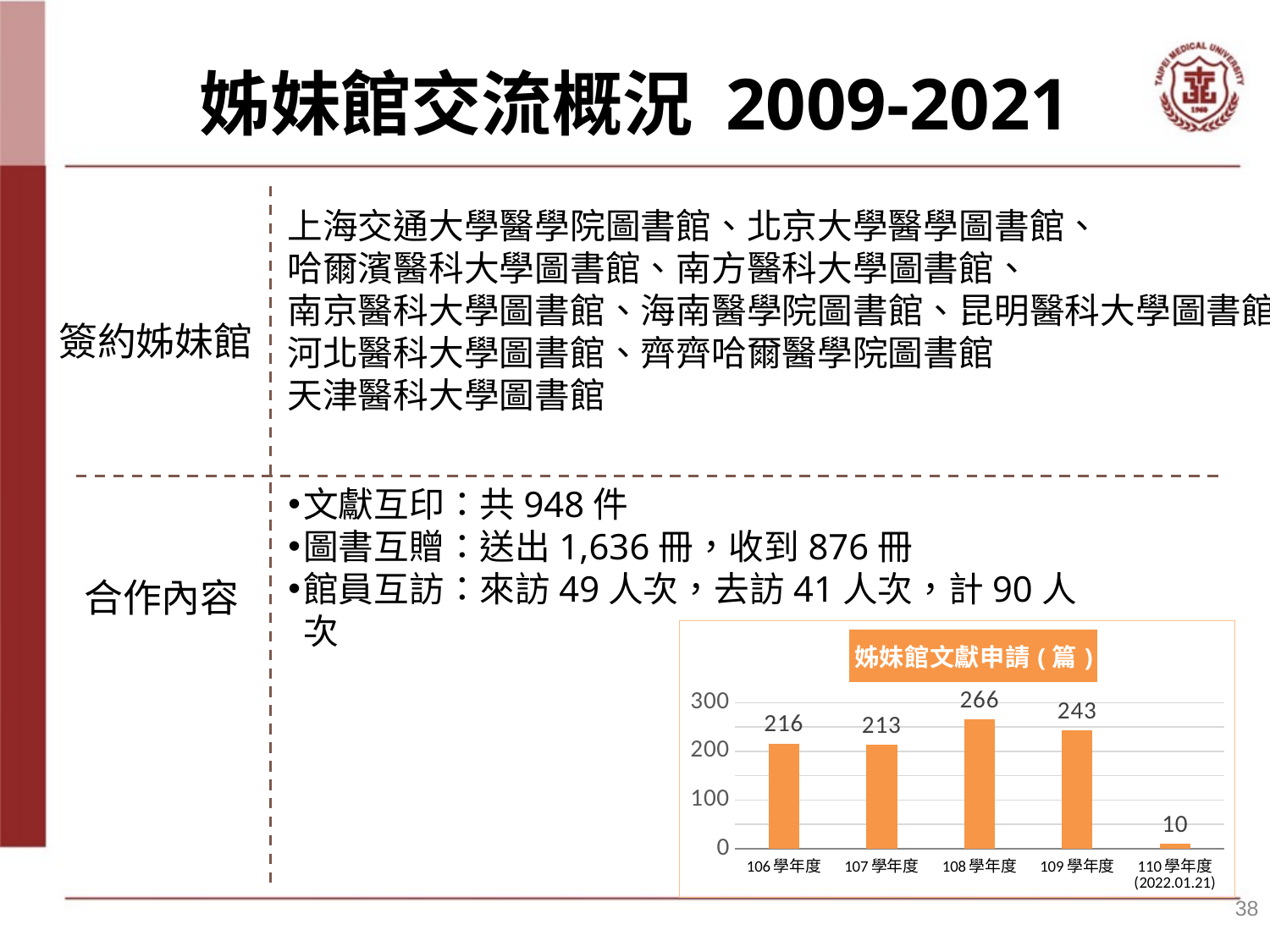
Is the value for 108 學年度 greater or less than 200? greater Which is larger, the value for 109 學年度 or the value for 107 學年度? 109 學年度 What is the title of the chart? 姊妹館文獻申請 ( 篇 ) Which academic year has the highest value in the chart? 108 學年度 What kind of chart is shown on the slide? bar chart What is the value for 106 學年度 in the chart? 216 What is the difference between the values for 106 學年度 and 107 學年度? 3 What is the difference between the values for 108 學年度 and 109 學年度? 23 How many academic years are shown in the chart? 5 Which academic year has the lowest value in the chart? 110 學年度 (2022.01.21) What is the value for 108 學年度 in the 姊妹館文獻申請 ( 篇 ) chart? 266 What is the value for 110 學年度 (2022.01.21) in the chart? 10